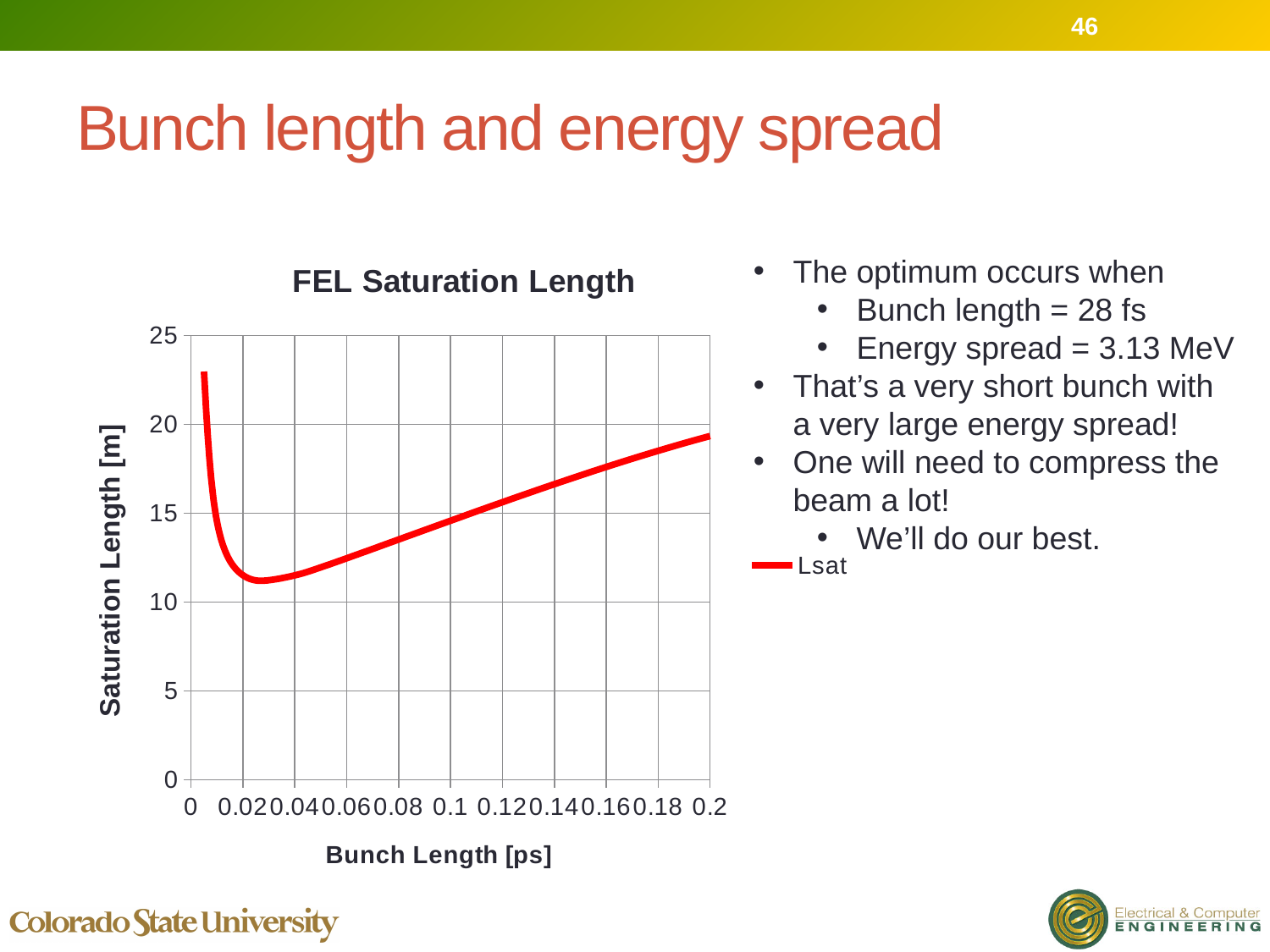
Is the value of Lsat at a bunch length of 0.1 ps greater or less than 10? greater What is the title of the chart? FEL Saturation Length Is the minimum value of the Lsat curve greater or less than 15? less Between bunch lengths of 0 ps and 0.02 ps, does the Lsat curve rise or fall? fall What kind of chart is shown on the slide? line chart Is the value of Lsat at a bunch length of 0.2 ps greater or less than 15? greater How many series does the chart's legend list? 1 Which is larger, the value of Lsat at 0.2 ps or at 0.1 ps? 0.2 ps Between bunch lengths of 0.05 ps and 0.2 ps, does the Lsat curve rise or fall? rise What is the name of the series shown in the legend? Lsat